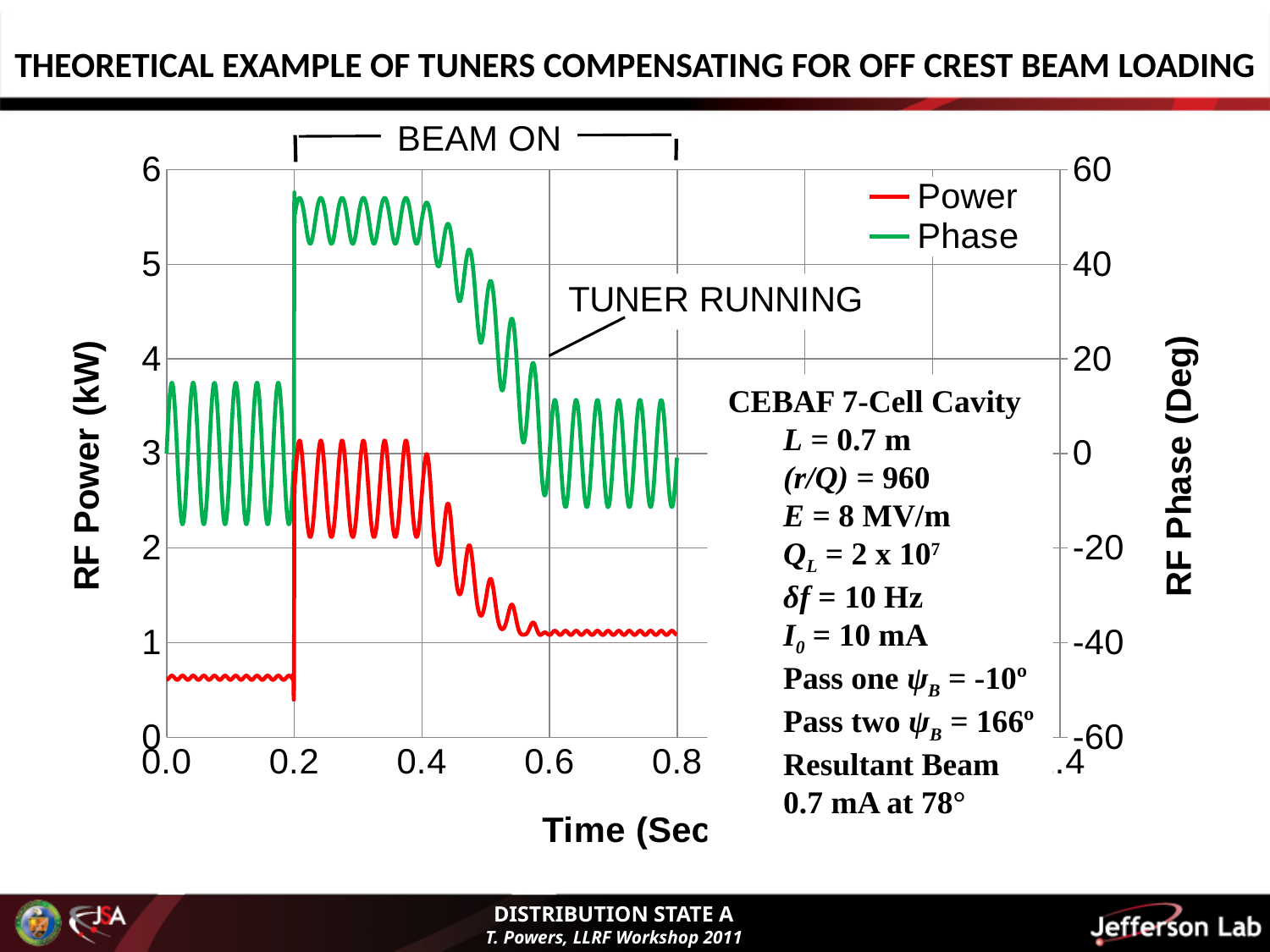
Which series has the higher value on its own axis between 0.2 and 0.4 seconds, Power (in kW) or Phase (in degrees)? Phase Is the Phase value between 0.2 and 0.4 seconds greater or less than 60 degrees? less What is the label of the left vertical axis? RF Power (kW) How many series does the chart legend list? 2 Is the Power value just before 0.2 seconds greater or less than 1 kW? less Does the Power series rise or fall between 0.4 and 0.6 seconds? fall Is the peak Power value between 0.2 and 0.4 seconds greater or less than 2 kW? greater Which series is drawn in red on the chart? Power Does the Phase series rise or fall between 0.4 and 0.6 seconds? fall What kind of chart is shown on the slide? line chart Does the Power series rise or fall at 0.2 seconds when the beam turns on? rise